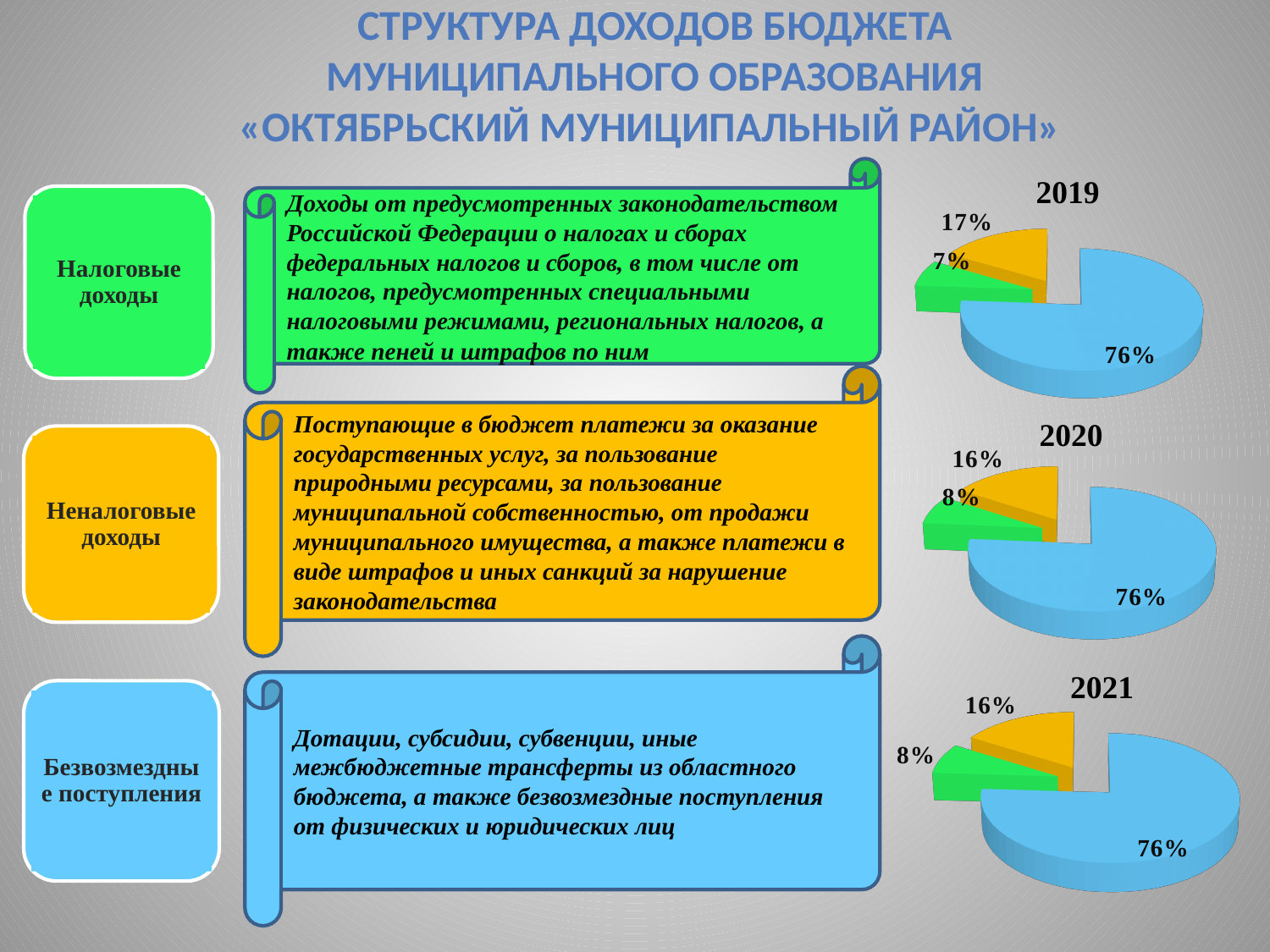
In the 2020 pie chart, which slice is the smallest? The green slice (8%) In the 2020 pie chart, what percentage is shown for the yellow slice? 16% In the 2019 pie chart, what percentage is shown for the green slice? 7% In the 2021 pie chart, what is the difference between the blue slice and the yellow slice? 60% In the 2019 pie chart, what percentage is shown for the blue slice? 76% How many pie charts are shown on the slide? 3 In the 2019 pie chart, what is the difference between the yellow slice and the green slice? 10% In the 2019 pie chart, which slice is the largest? The blue slice (76%) How many slices does the 2021 pie chart have? 3 What type of chart is used to show the 2020 data? Pie chart Is the green slice larger in the 2019 pie chart or in the 2020 pie chart? 2020 In the 2021 pie chart, what percentage is shown for the green slice? 8%